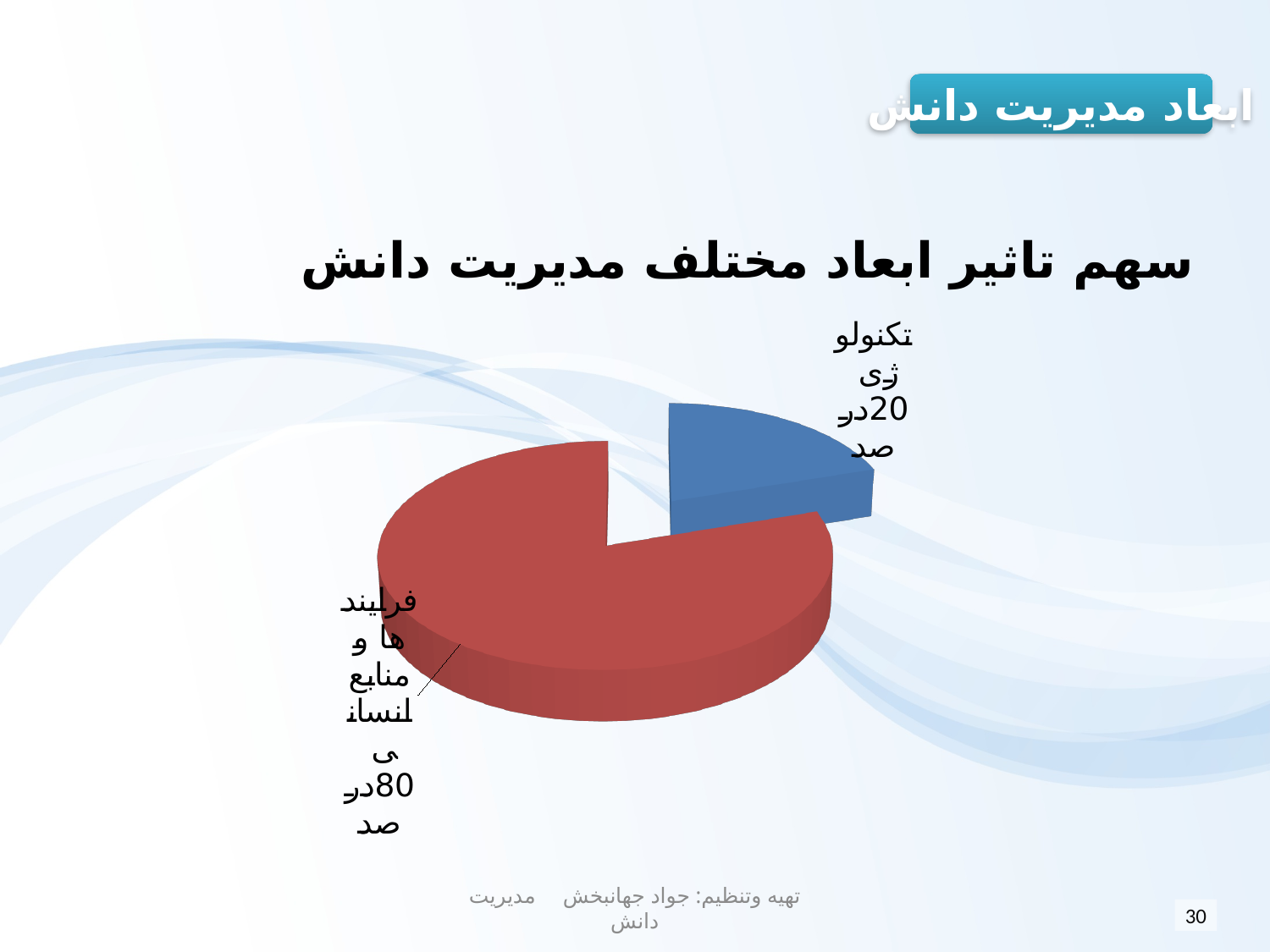
What is the difference in percentage points between the فرایندها و منابع انسانی slice and the تکنولوژی slice? 60 How many slices does the pie chart have? 2 What colour is the slice for تکنولوژی? blue What is the title of the pie chart? سهم تاثیر ابعاد مختلف مدیریت دانش What value is printed on the slice labelled فرایندها و منابع انسانی? 80درصد What share of the pie does the تکنولوژی slice represent? 20درصد Which is larger, the slice for تکنولوژی or the slice for فرایندها و منابع انسانی? فرایندها و منابع انسانی Which slice of the pie chart is the smallest? تکنولوژی What value is printed on the slice labelled تکنولوژی? 20درصد Which slice of the pie chart is the largest? فرایندها و منابع انسانی What kind of chart is shown on the slide? pie chart